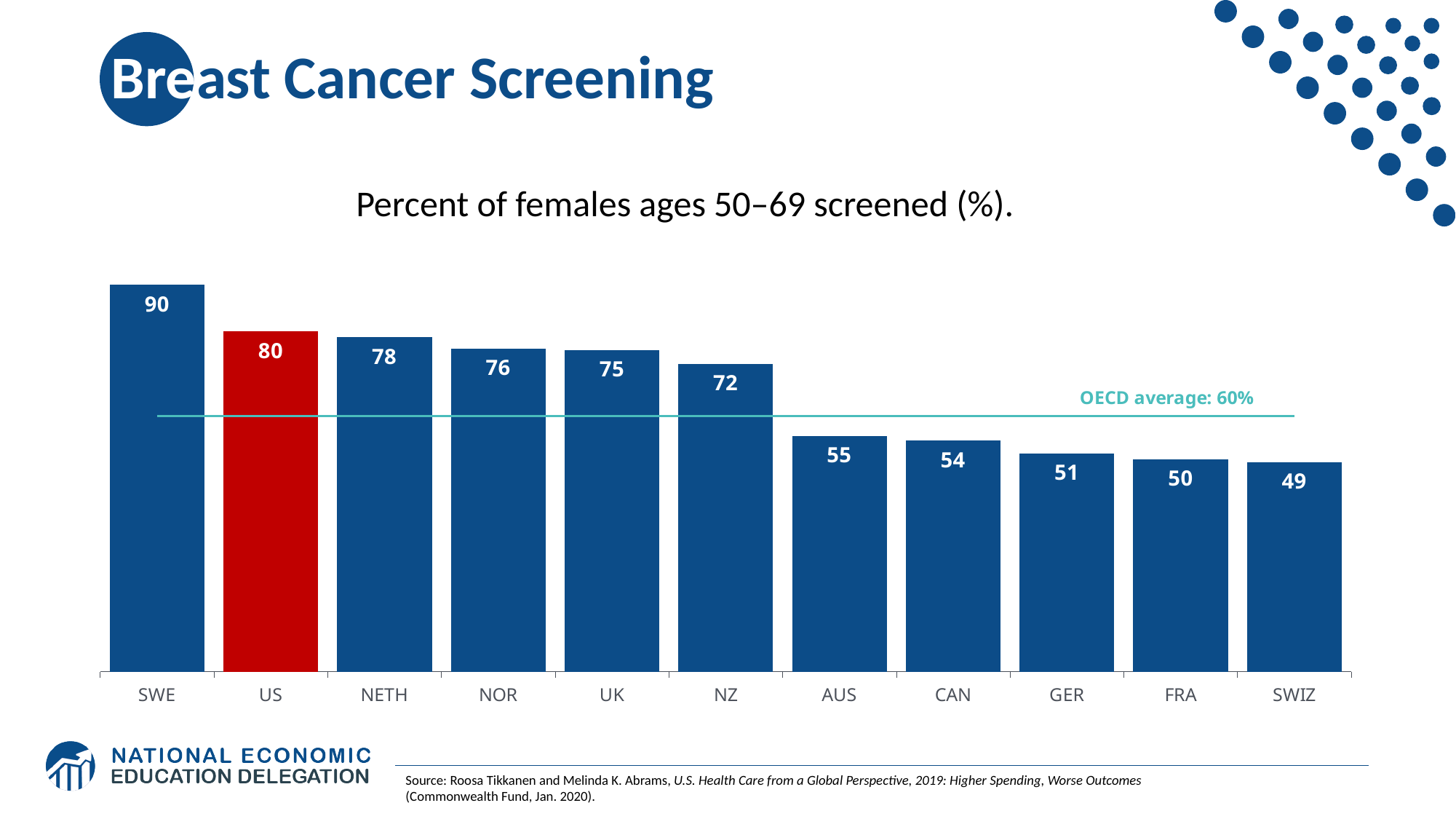
What is the value for NZ? 72 What OECD average is marked by the horizontal line on the chart? 60% What is the value for the US? 80 Do the values rise or fall from left to right along the x axis? Fall What is the difference between the values for NETH and AUS? 23 What is the difference between the values for SWE and the US? 10 Which country has the highest value? SWE How many countries are shown on the chart? 11 What kind of chart is shown on the slide? Bar chart Which is larger, the value for NOR or the value for CAN? NOR What is the value for FRA? 50 Which country has the lowest value? SWIZ